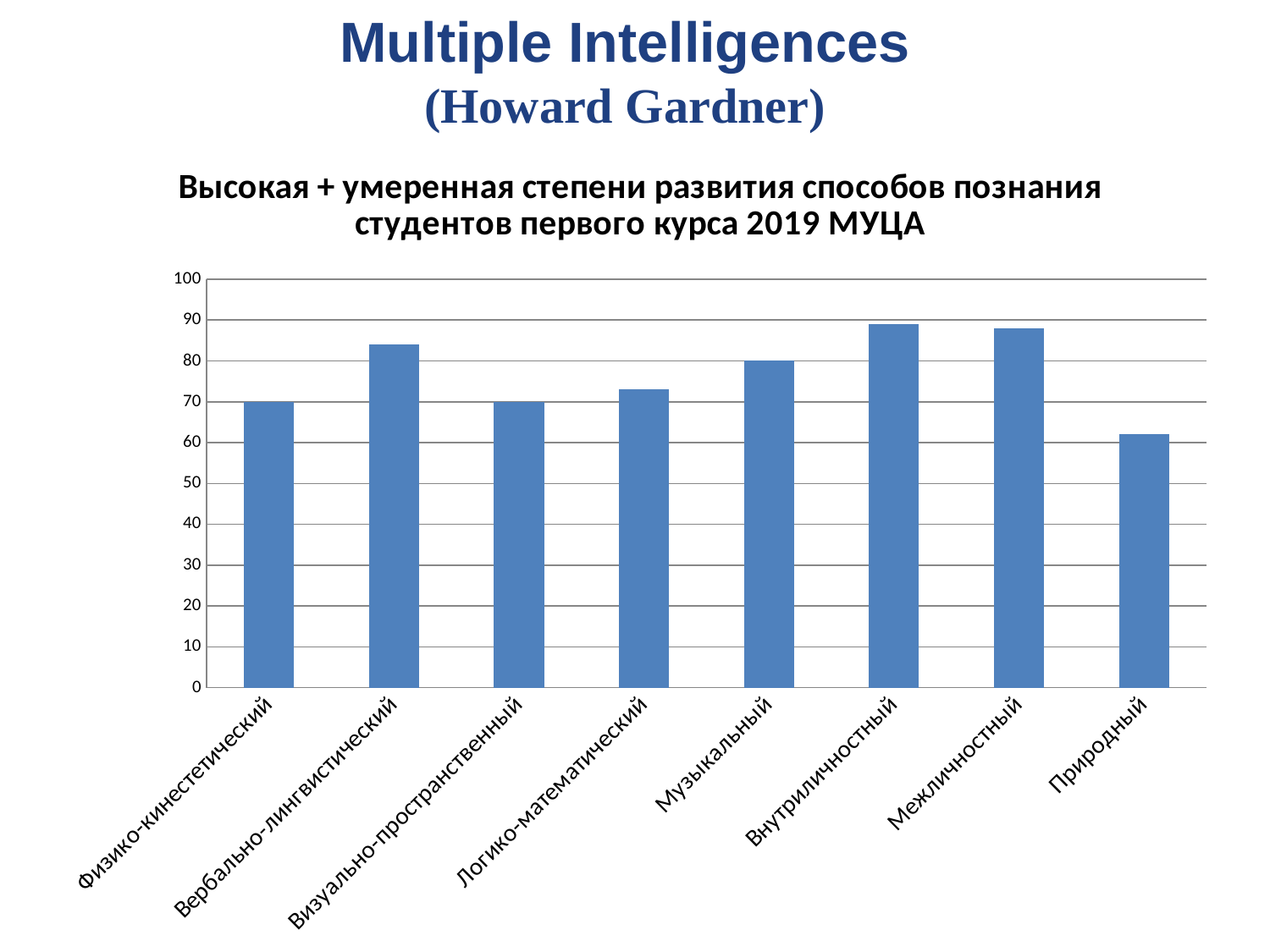
What is the value for Физико-кинестетический? 70 Which category has the lowest value in the chart? Природный Which is larger, the value for Музыкальный or the value for Природный? Музыкальный Is the value for Логико-математический greater or less than 70? greater How many categories are shown on the x axis of the chart? 8 Which is larger, the value for Вербально-лингвистический or the value for Физико-кинестетический? Вербально-лингвистический What is the value for Визуально-пространственный? 70 What kind of chart is shown on the slide? bar chart Is the value for Вербально-лингвистический greater or less than 80? greater What is the value for Музыкальный? 80 Is the value for Природный greater or less than 70? less